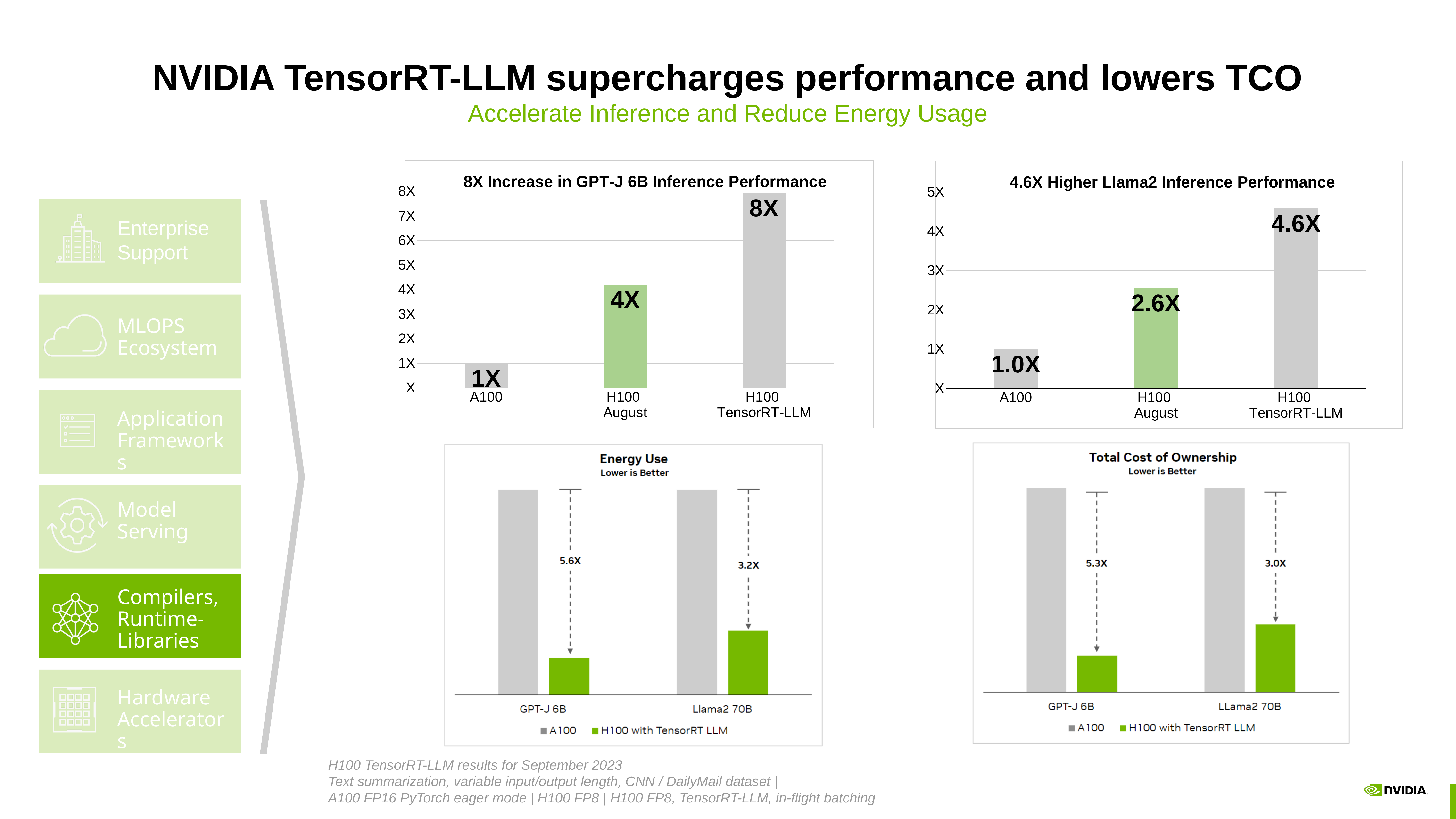
In the chart titled '8X Increase in GPT-J 6B Inference Performance', how many bars are plotted? 3 In the chart titled '4.6X Higher Llama2 Inference Performance', which category has the lowest value? A100 In the 'Total Cost of Ownership' chart, which series is larger for GPT-J 6B, A100 or H100 with TensorRT LLM? A100 In the chart titled '4.6X Higher Llama2 Inference Performance', what is the value for H100 August? 2.6X In the chart titled '8X Increase in GPT-J 6B Inference Performance', what is the value for H100 August? 4X In the chart titled '4.6X Higher Llama2 Inference Performance', is the value for H100 TensorRT-LLM greater or less than 4X? greater In the chart titled '4.6X Higher Llama2 Inference Performance', what is the value for A100? 1.0X In the chart titled '4.6X Higher Llama2 Inference Performance', do the values rise or fall from left to right along the x axis? rise What kind of chart is the 'Total Cost of Ownership' chart? bar chart In the chart titled '8X Increase in GPT-J 6B Inference Performance', what is the difference between the H100 TensorRT-LLM value and the A100 value? 7X In the chart titled '8X Increase in GPT-J 6B Inference Performance', which category has the highest value? H100 TensorRT-LLM In the 'Energy Use' chart, how many series does the legend list? 2